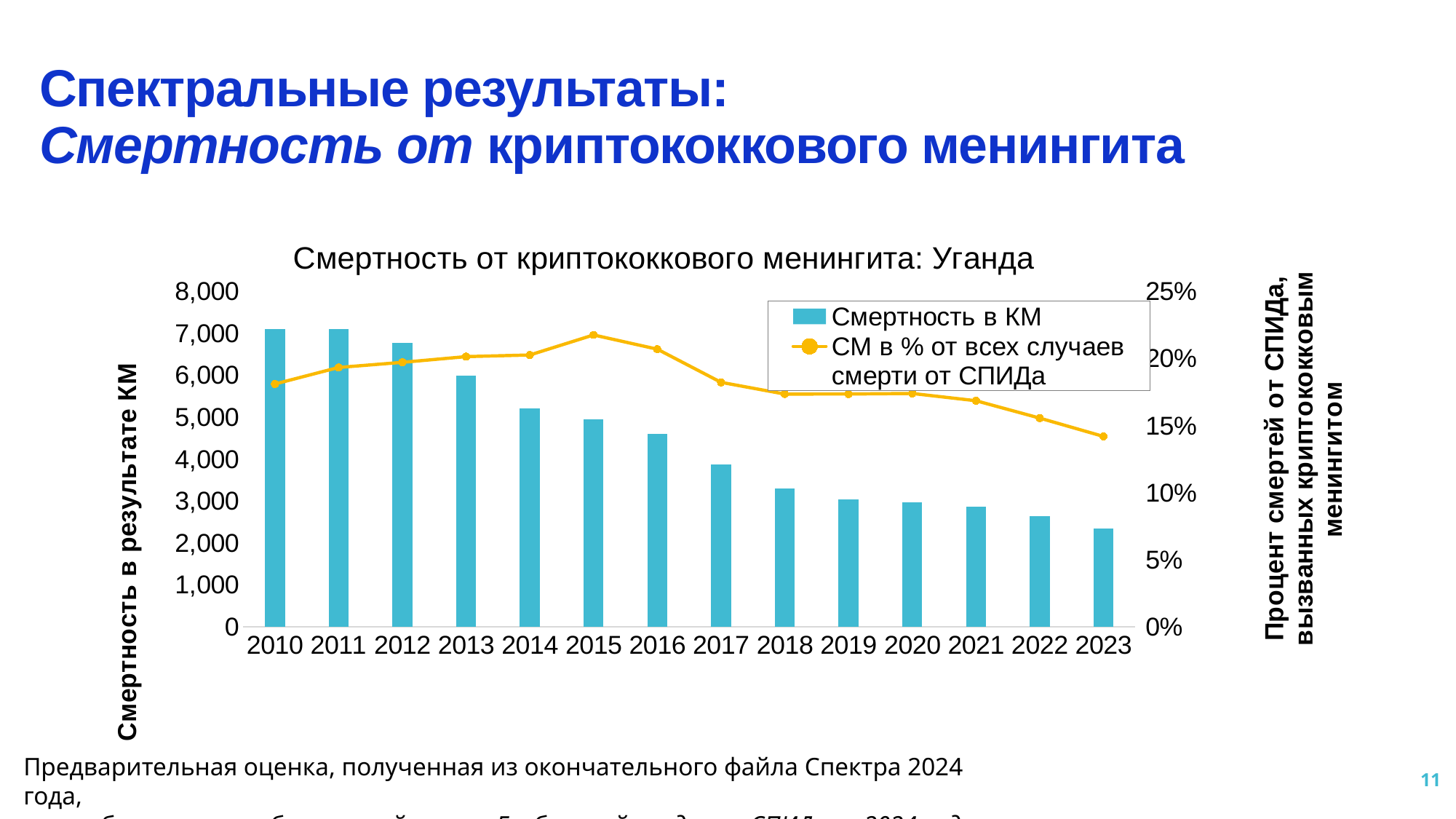
Is the value for 'Смертность в КМ' in 2023 greater or less than 3,000? less Do the bars for 'Смертность в КМ' generally rise or fall from 2010 to 2023? Fall How many years are shown on the x axis? 14 Which year has the highest value for 'СМ в % от всех случаев смерти от СПИДа'? 2015 What is the title of the chart? Смертность от криптококкового менингита: Уганда Which year has the larger value for 'Смертность в КМ', 2012 or 2013? 2012 Is the value for 'Смертность в КМ' in 2016 greater or less than 4,000? greater Which year has the lowest value for 'Смертность в КМ'? 2023 How many series does the legend list? 2 Which year has the lowest value for 'СМ в % от всех случаев смерти от СПИДа'? 2023 What kind of chart is shown on the slide? Combined bar and line chart Is the value for 'СМ в % от всех случаев смерти от СПИДа' in 2015 greater or less than 20%? greater